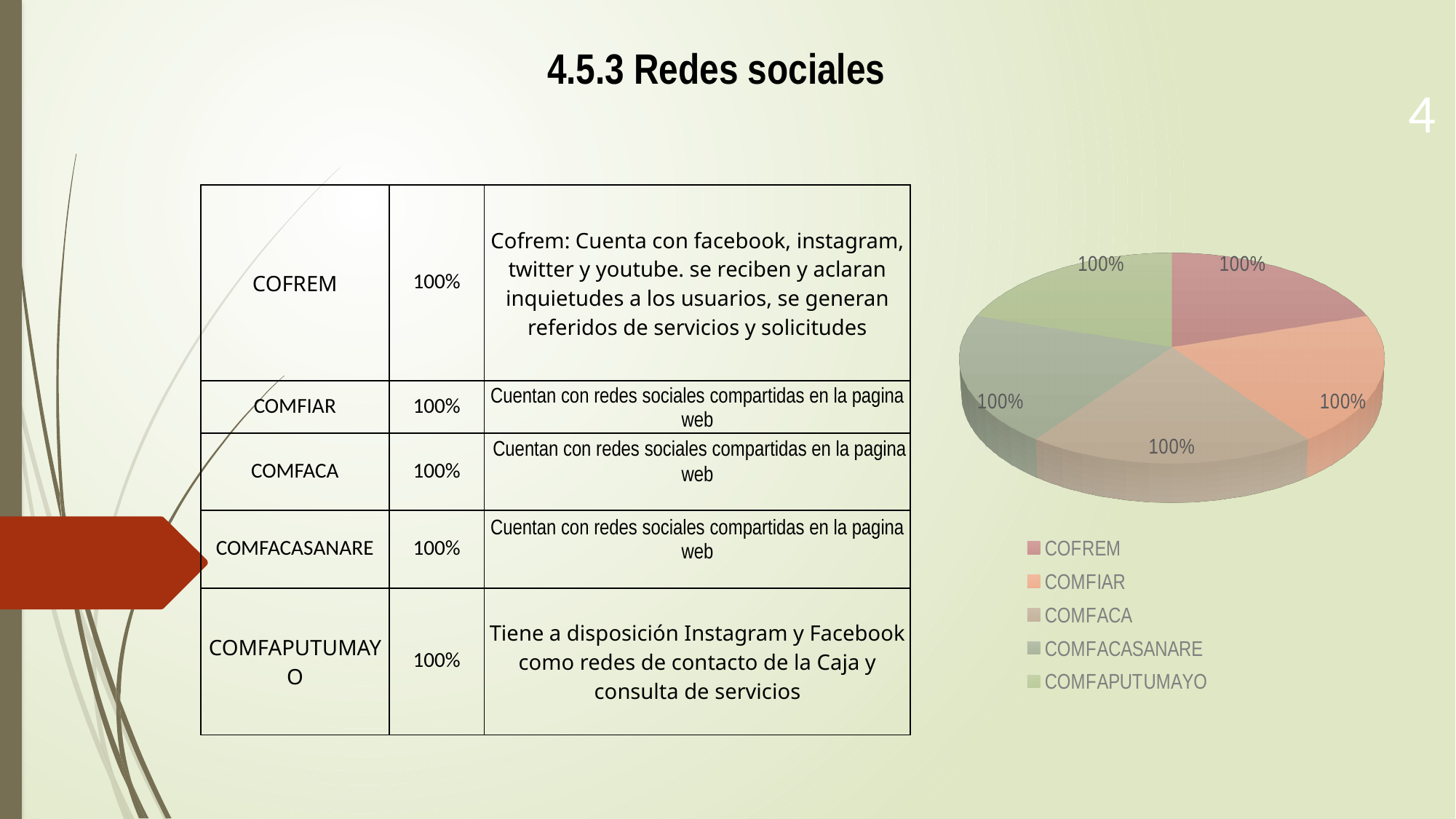
What kind of chart is shown on the slide? pie chart What is the difference between the values labelled for COFREM and COMFIAR in the pie chart? 0% What value is labelled on the COMFACASANARE slice of the pie chart? 100% What value is labelled on the COMFACA slice of the pie chart? 100% How many slices does the pie chart have? 5 How many entries does the legend of the pie chart list? 5 What value is labelled on the COMFAPUTUMAYO slice of the pie chart? 100% What value is labelled on the COFREM slice of the pie chart? 100% Which legend entry is listed last in the pie chart's legend? COMFAPUTUMAYO Which legend entry is listed first in the pie chart's legend? COFREM What value is labelled on the COMFIAR slice of the pie chart? 100%